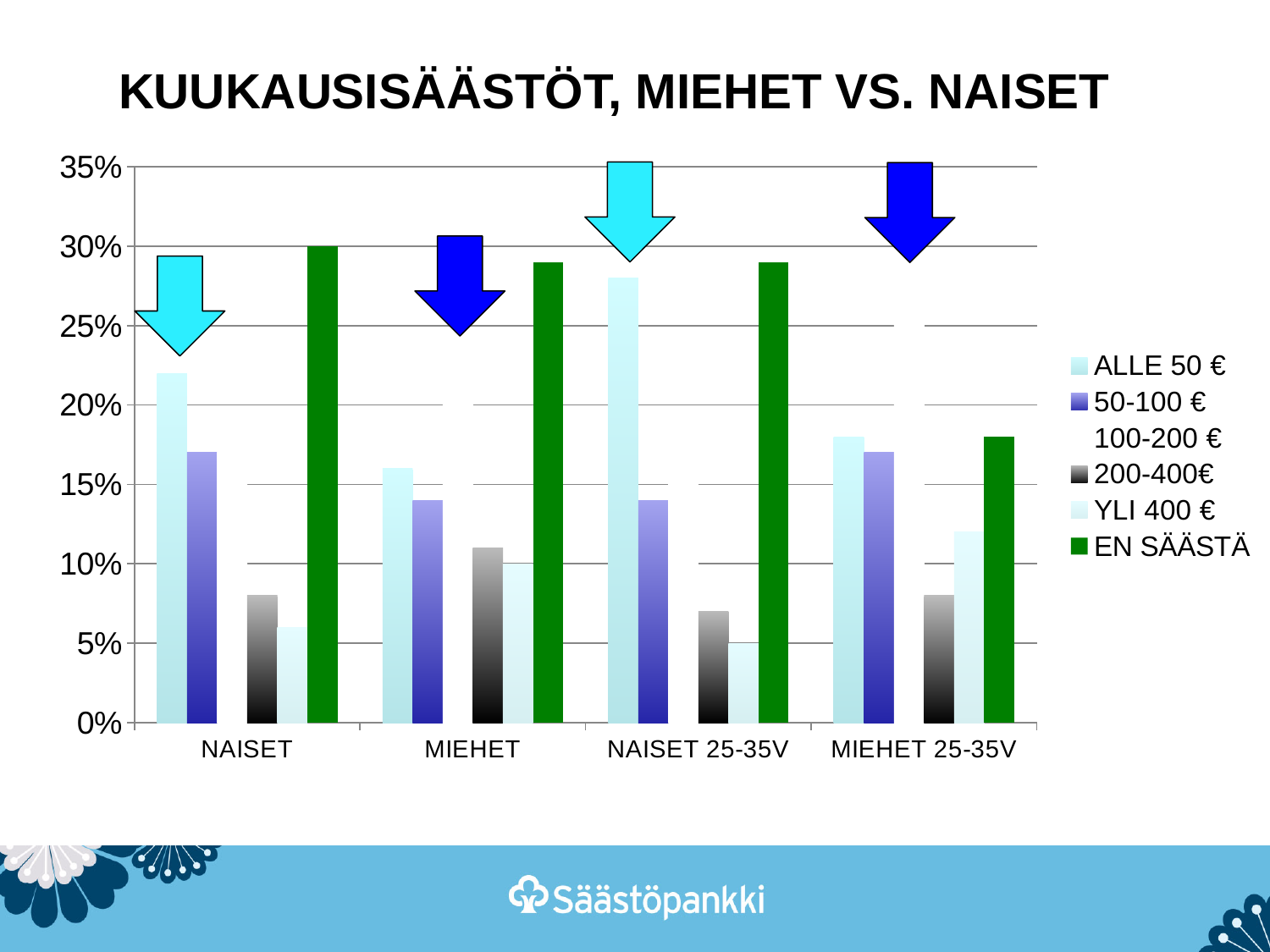
Which series has the highest value in the NAISET category? EN SÄÄSTÄ Is the ALLE 50 € value for NAISET greater or less than 20%? greater Is the ALLE 50 € value for NAISET 25-35V greater or less than 25%? greater How many categories are shown on the x axis? 4 What is the title of the chart? KUUKAUSISÄÄSTÖT, MIEHET VS. NAISET Which series has the lowest value in the MIEHET 25-35V category? 200-400€ Which series has the lowest value in the NAISET category? YLI 400 € How many series does the legend list? 6 Which is larger, the ALLE 50 € value for NAISET or the ALLE 50 € value for MIEHET? NAISET What kind of chart is shown on the slide? bar chart Which is larger, the EN SÄÄSTÄ value for NAISET or the EN SÄÄSTÄ value for MIEHET 25-35V? NAISET Which series has the lowest value in the NAISET 25-35V category? YLI 400 €